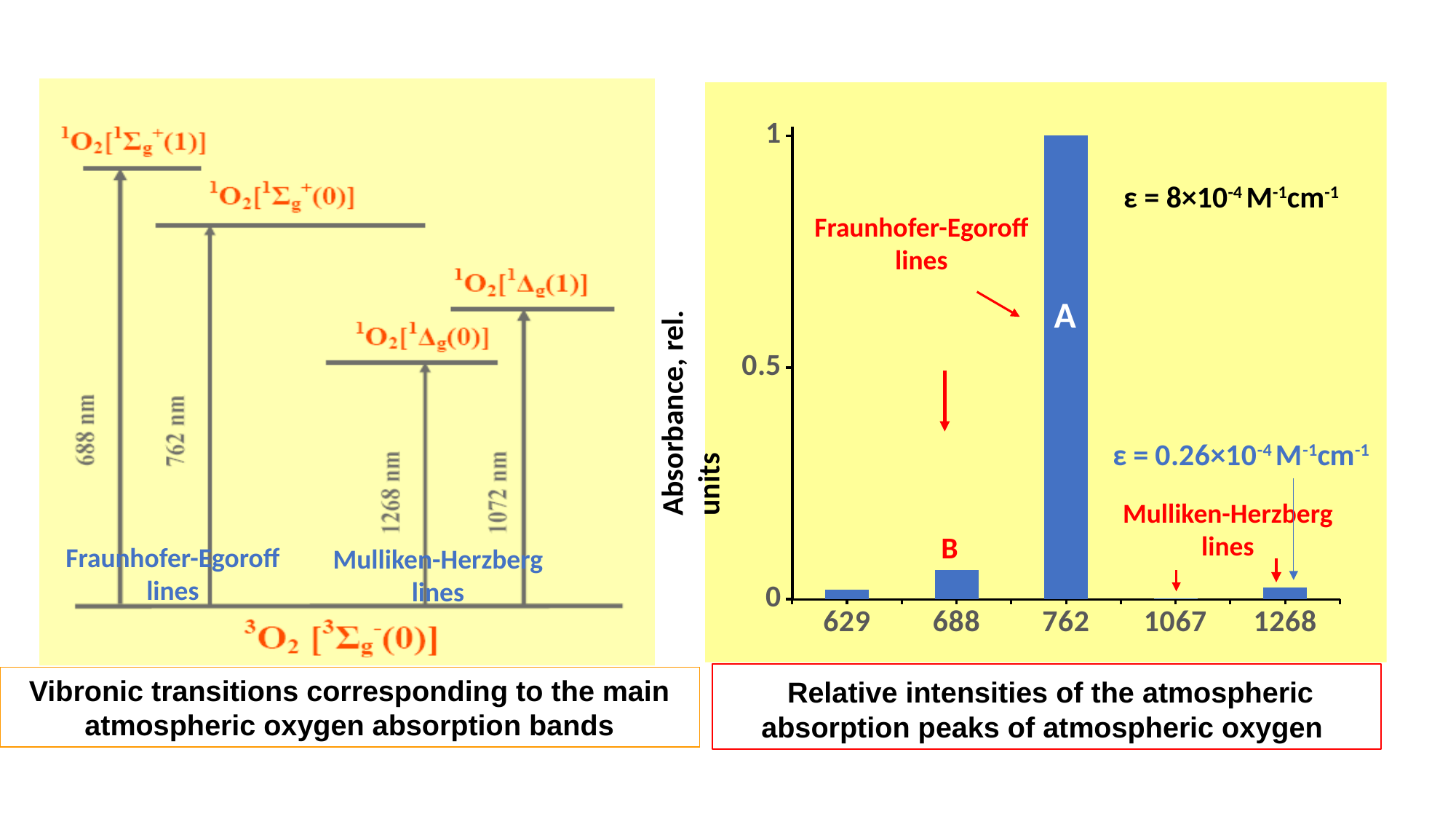
What kind of chart is shown on the right side of the slide? bar chart In the bar chart on the right, what is the absorbance value for the 762 bar? 1 In the bar chart on the right, which has the larger absorbance, 688 or 1268? 688 In the bar chart on the right, which letter labels the tallest bar at 762? A In the bar chart on the right, which has the larger absorbance, 762 or 688? 762 How many bars (wavelength categories) are plotted in the bar chart on the right? 5 In the bar chart on the right, which wavelength has the highest absorbance? 762 In the bar chart on the right, which has the larger absorbance, 688 or 629? 688 In the bar chart on the right, is the absorbance for 688 greater or less than 0.5? less In the bar chart on the right, is the absorbance for 1268 greater or less than 0.5? less What is the y-axis label of the bar chart on the right? Absorbance, rel. units In the bar chart on the right, which wavelength has the lowest absorbance? 1067